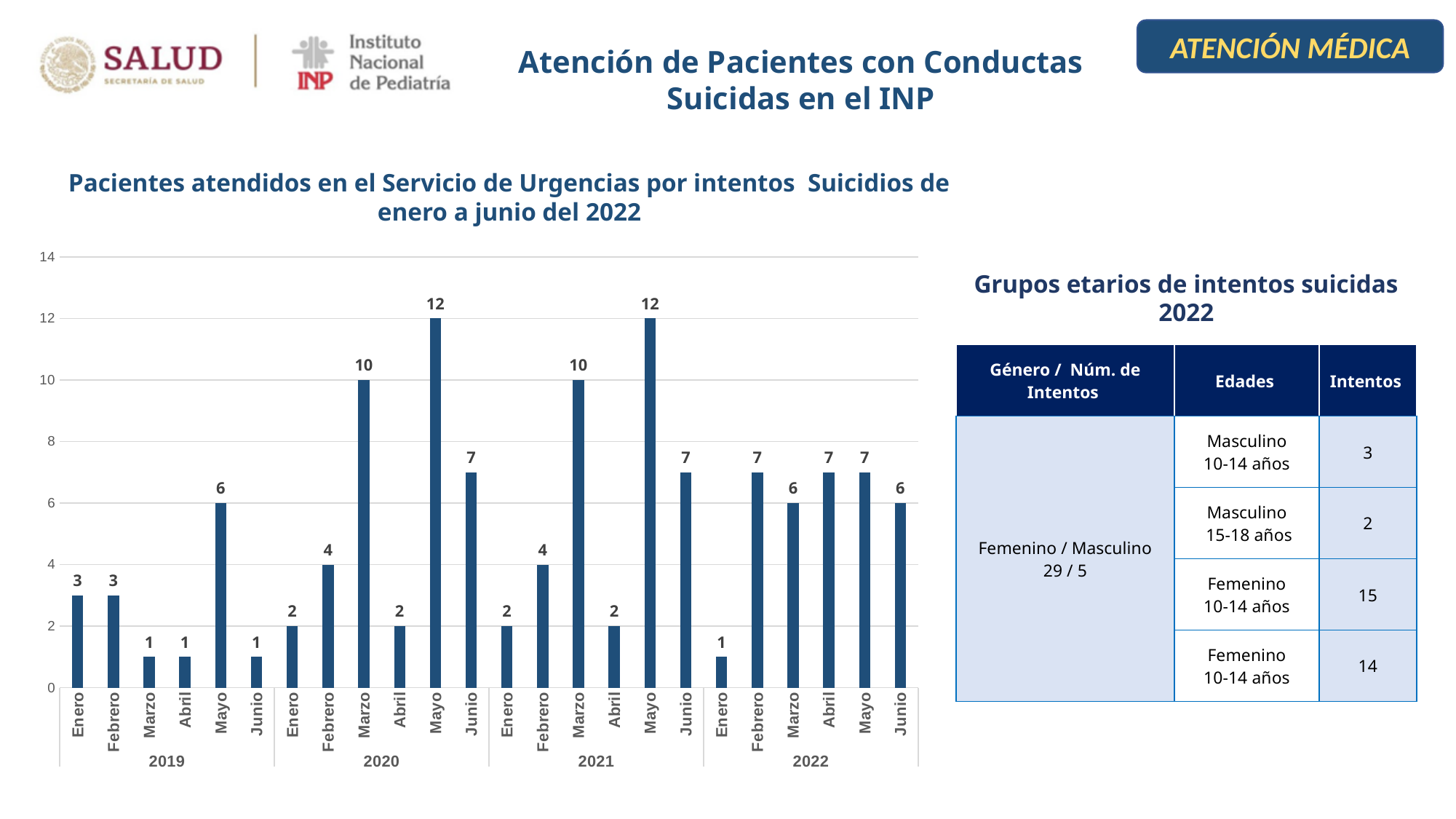
What type of chart is shown on the slide? bar chart How many bars are plotted in the chart? 24 How many patients were attended in Mayo 2020? 12 What is the value for Febrero 2022? 7 What is the value for Junio 2019? 1 What is the highest value shown in the chart? 12 What is the value for Marzo 2021? 10 What is the difference between the values for Mayo 2020 and Mayo 2019? 6 Which is larger, the value for Febrero 2021 or the value for Febrero 2022? Febrero 2022 Do the values rise or fall from Enero to Marzo in 2020? rise What is the difference between the values for Marzo 2020 and Marzo 2022? 4 What is the total of the values for the six months of 2022? 34